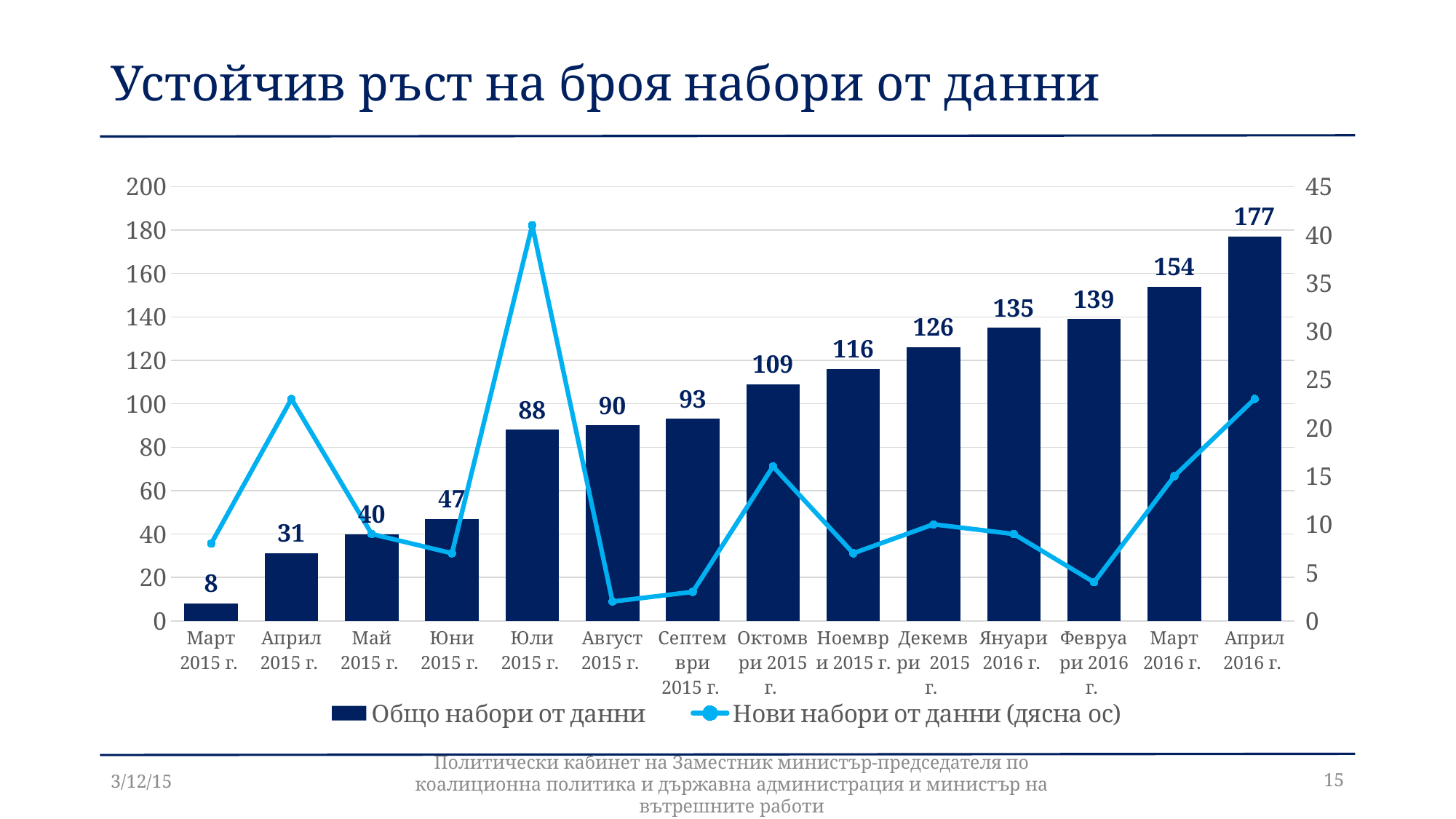
Is the value of "Нови набори от данни (дясна ос)" for Август 2015 г. greater or less than 5 on the right axis? less Do the "Общо набори от данни" values rise or fall from Март 2015 г. to Април 2016 г.? rise How many series does the legend list? 2 What is the value of "Общо набори от данни" for Април 2016 г.? 177 Is the value of "Нови набори от данни (дясна ос)" for Юли 2015 г. greater or less than 35 on the right axis? greater Which is larger, the "Общо набори от данни" value for Октомври 2015 г. or for Ноември 2015 г.? Ноември 2015 г. Which month has the highest value of "Общо набори от данни"? Април 2016 г. How many months are shown on the x axis of the chart? 14 What is the value of "Общо набори от данни" for Март 2015 г.? 8 Which month has the lowest value of "Общо набори от данни"? Март 2015 г. What is the value of "Общо набори от данни" for Юли 2015 г.? 88 What is the difference between the "Общо набори от данни" values for Април 2016 г. and Март 2016 г.? 23